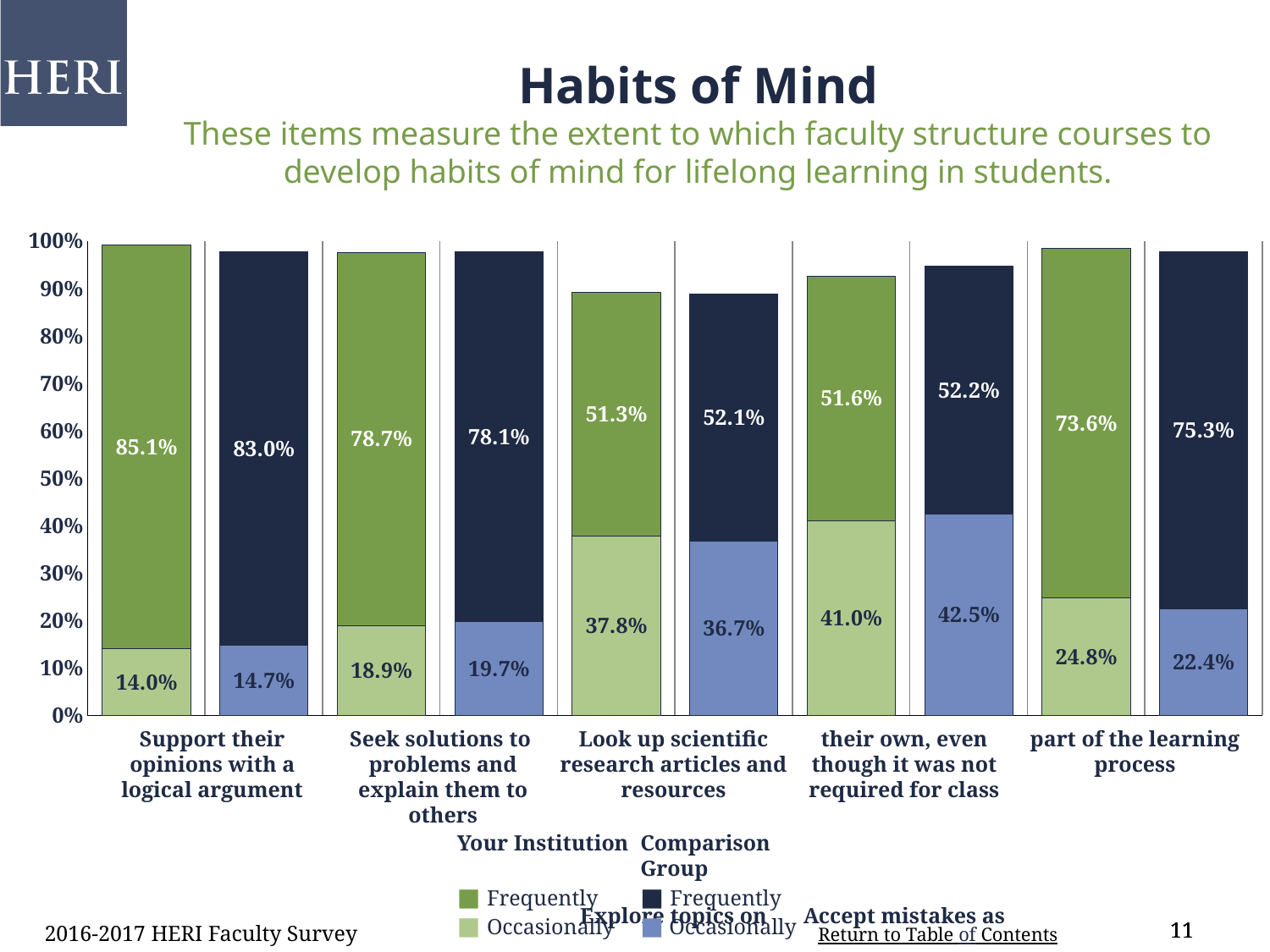
What kind of chart is shown on the slide? Stacked bar chart What is the total of the Comparison Group stacked bar for 'Explore topics on their own, even though it was not required for class'? 94.7% How many entries does the legend list? 4 For 'Accept mistakes as part of the learning process', which is larger: the Your Institution 'Frequently' value or the Comparison Group 'Frequently' value? Comparison Group (75.3%) What is the Your Institution 'Occasionally' value for 'Look up scientific research articles and resources'? 37.8% What is the total of the Your Institution stacked bar for 'Look up scientific research articles and resources'? 89.1% What is the difference between the Your Institution and Comparison Group 'Frequently' values for 'Support their opinions with a logical argument'? 2.1% What is the Comparison Group 'Occasionally' value for 'Seek solutions to problems and explain them to others'? 19.7% Which category has the highest Your Institution 'Frequently' value? Support their opinions with a logical argument What percentage of Your Institution faculty report 'Frequently' for 'Support their opinions with a logical argument'? 85.1% Which category has the lowest Comparison Group 'Frequently' value? Look up scientific research articles and resources How many categories are shown on the x axis of the chart? 5